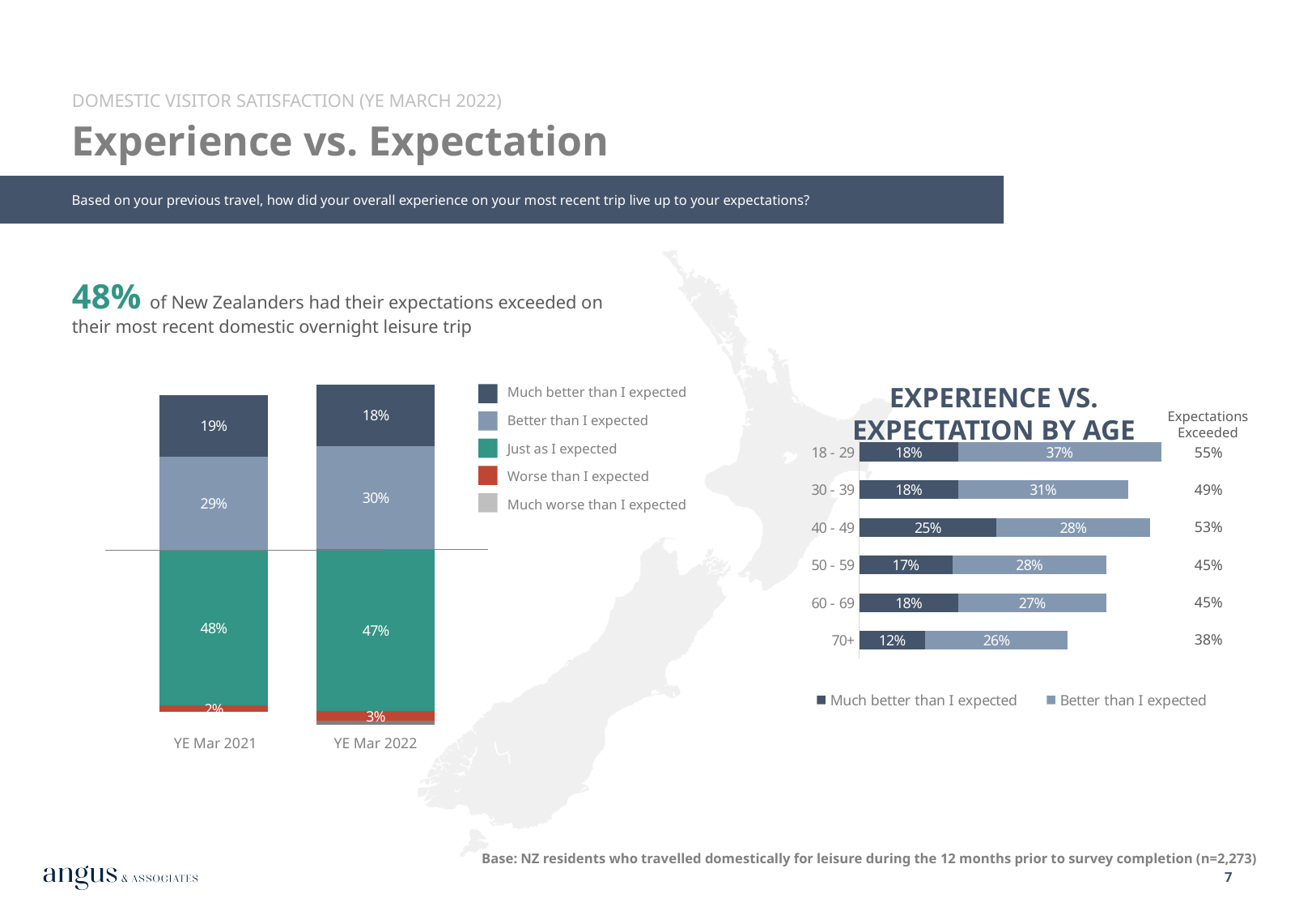
In the left-hand chart, which year has the larger 'Better than I expected' value, YE Mar 2021 or YE Mar 2022? YE Mar 2022 What type of chart is the left-hand chart comparing YE Mar 2021 and YE Mar 2022? Stacked bar chart In the 'Experience vs. Expectation by Age' chart, what percentage of the 18 - 29 age group said their experience was 'Better than I expected'? 37% In the 'Experience vs. Expectation by Age' chart, which age group has the highest 'Expectations Exceeded' percentage? 18 - 29 In the left-hand chart, what is the 'Worse than I expected' value for YE Mar 2021? 2% In the 'Experience vs. Expectation by Age' chart, which age group has the lowest 'Much better than I expected' value? 70+ In the 'Experience vs. Expectation by Age' chart, how many series does the legend list? 2 In the 'Experience vs. Expectation by Age' chart, what is the difference between the 'Expectations Exceeded' percentages for the 18 - 29 and 70+ age groups? 17% In the 'Experience vs. Expectation by Age' chart, what is the 'Much better than I expected' value for the 40 - 49 age group? 25% In the 'Experience vs. Expectation by Age' chart, how many age groups are shown? 6 In the left-hand chart, how many series does the legend list? 5 In the left-hand chart, what percentage of respondents in YE Mar 2022 said their experience was 'Just as I expected'? 47%